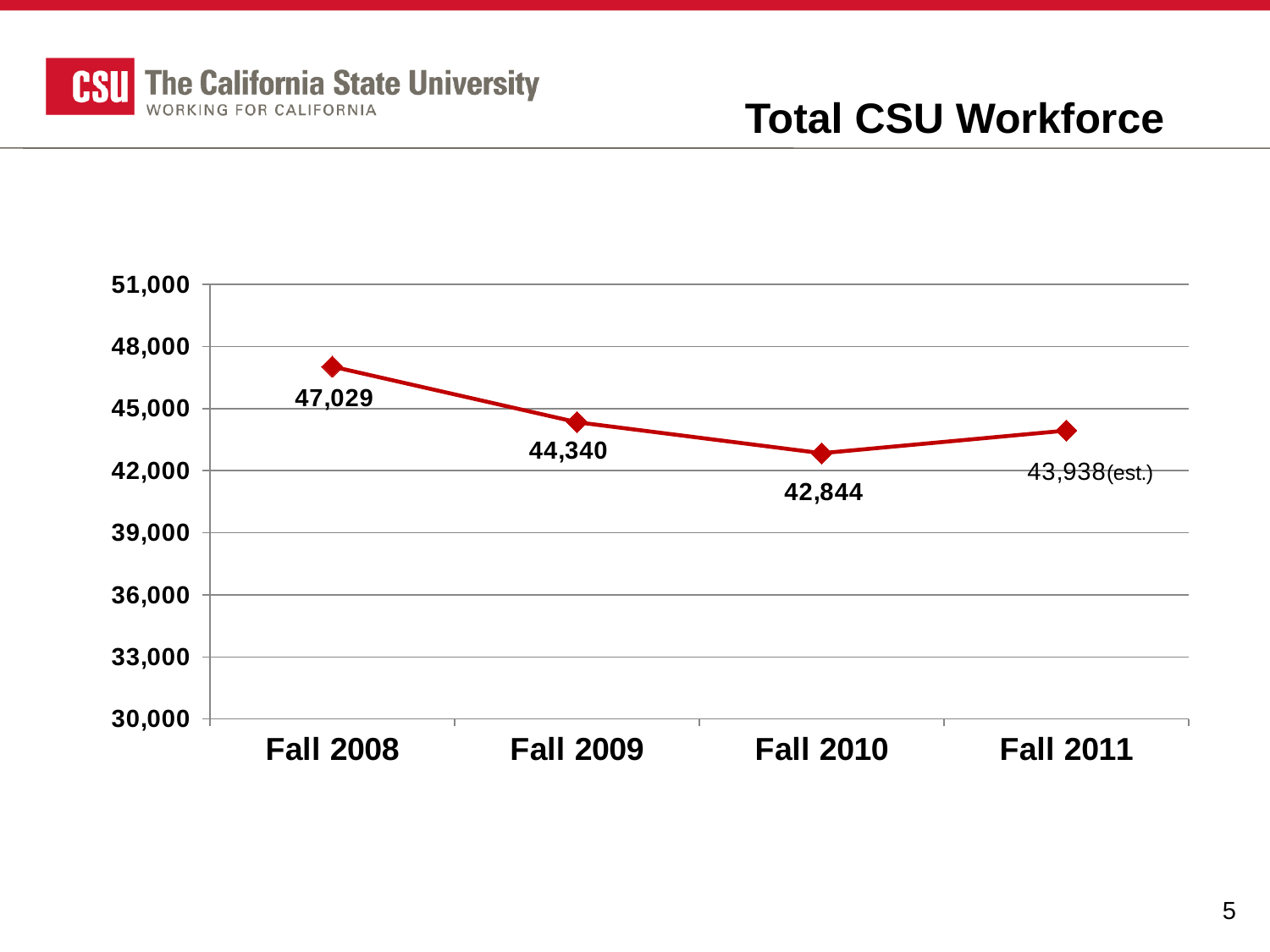
What is the estimated total CSU workforce value for Fall 2011? 43,938 What is the total CSU workforce value for Fall 2010? 42,844 Which period has the highest total CSU workforce? Fall 2008 How many data points are plotted on the chart? 4 Which period has the lowest total CSU workforce? Fall 2010 What is the difference between the Fall 2011 and Fall 2010 workforce values? 1,094 What is the total CSU workforce value for Fall 2008? 47,029 What kind of chart is shown on the slide? Line chart Does the total CSU workforce rise or fall from Fall 2008 to Fall 2010? Fall What is the total CSU workforce value for Fall 2009? 44,340 What is the difference between the Fall 2008 and Fall 2009 workforce values? 2,689 Which is larger, the workforce value for Fall 2009 or Fall 2011? Fall 2009